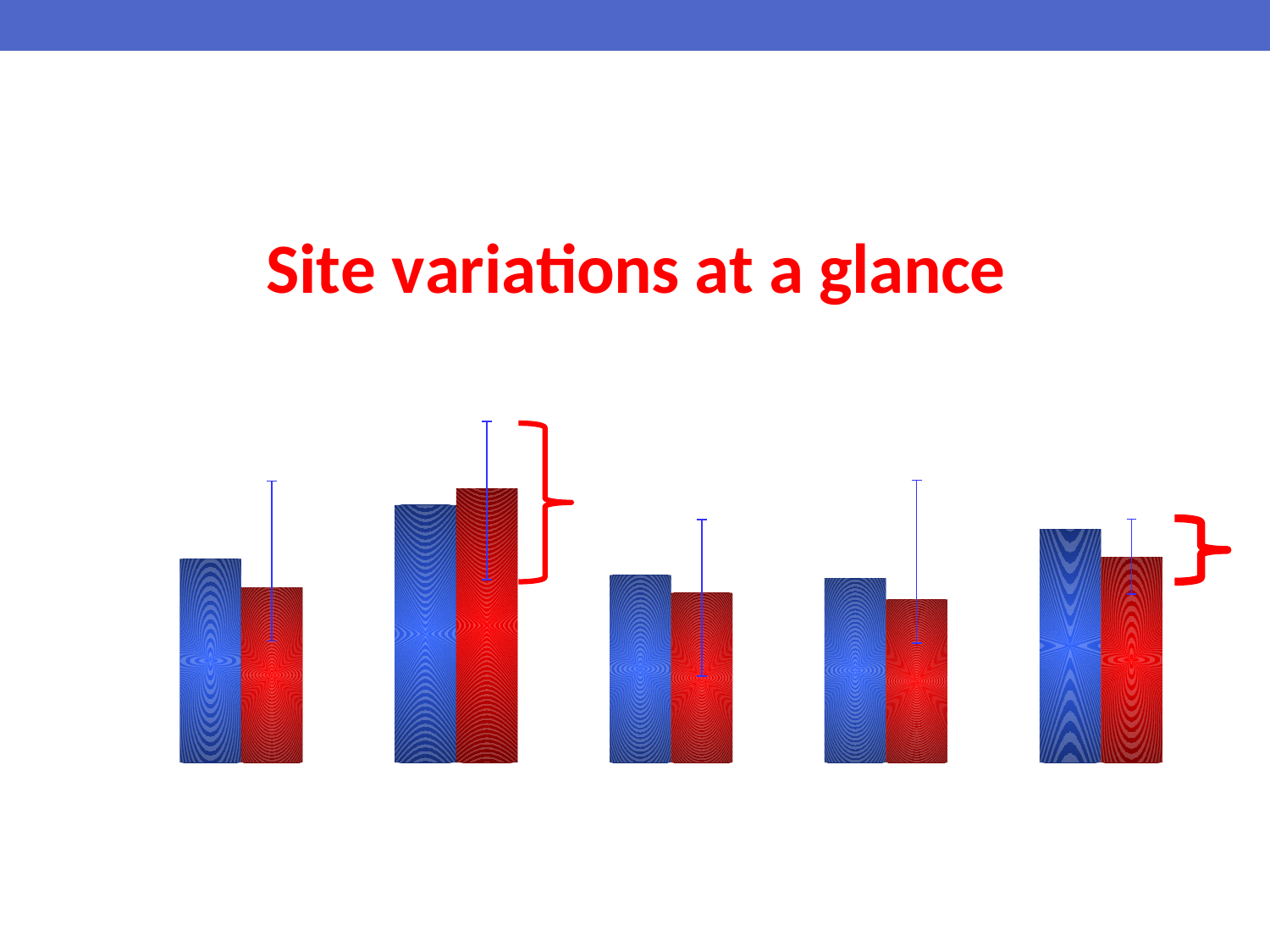
What kind of chart is shown on the slide? bar chart What two colours are used for the bars in each group? blue and red In the second group from the left, which bar is taller, the blue one or the red one? the red one In the fifth group from the left, which bar is taller, the blue one or the red one? the blue one What is the title of the slide above the chart? Site variations at a glance Which group of bars, counting from the left, has the tallest red bar? the second group In the first group from the left, which bar is taller, the blue one or the red one? the blue one How many bars are there in each group? 2 How many groups of bars are plotted in the chart? 5 Which group of bars, counting from the left, has the tallest bars? the second group Which group of bars, counting from the left, has the tallest blue bar? the second group